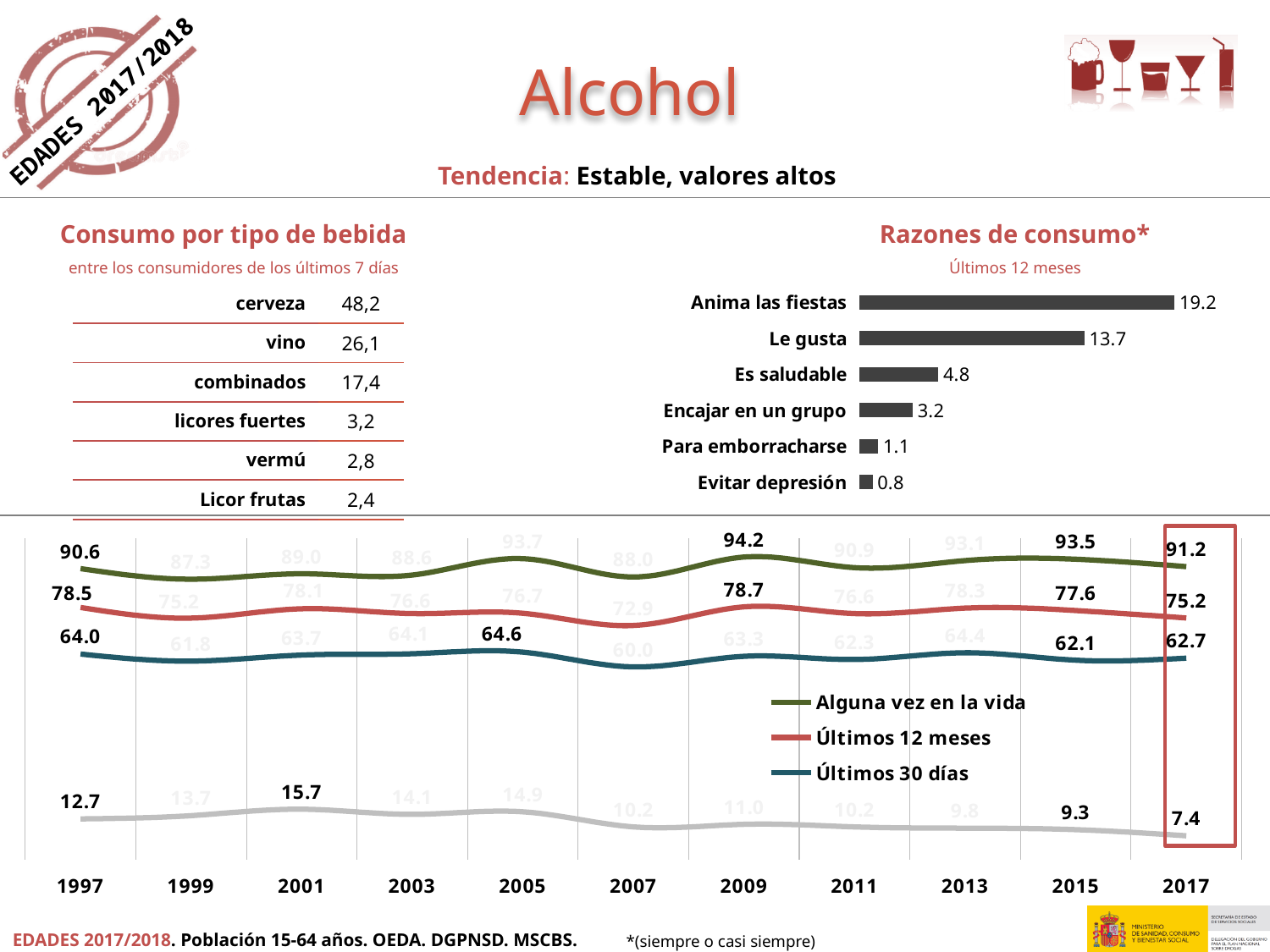
In the 'Razones de consumo' chart, how many reasons are listed? 6 In the 'Razones de consumo' chart, what is the value for 'Anima las fiestas'? 19.2 In the line chart at the bottom, what is the value of 'Últimos 12 meses' in 2017? 75.2 In the line chart at the bottom, how many series does the legend list? 3 In the 'Razones de consumo' chart, which reason has the lowest value? Evitar depresión In the line chart at the bottom, what is the value of 'Últimos 30 días' in 2005? 64.6 In the line chart at the bottom, what is the difference between 'Alguna vez en la vida' and 'Últimos 12 meses' in 1997? 12.1 What kind of chart is 'Razones de consumo'? Bar chart In the 'Razones de consumo' chart, which is larger: 'Es saludable' or 'Encajar en un grupo'? Es saludable In the line chart at the bottom, what is the value of 'Alguna vez en la vida' in 2009? 94.2 In the 'Razones de consumo' chart, what is the difference between 'Anima las fiestas' and 'Le gusta'? 5.5 In the line chart at the bottom, how many years are shown on the x axis? 11